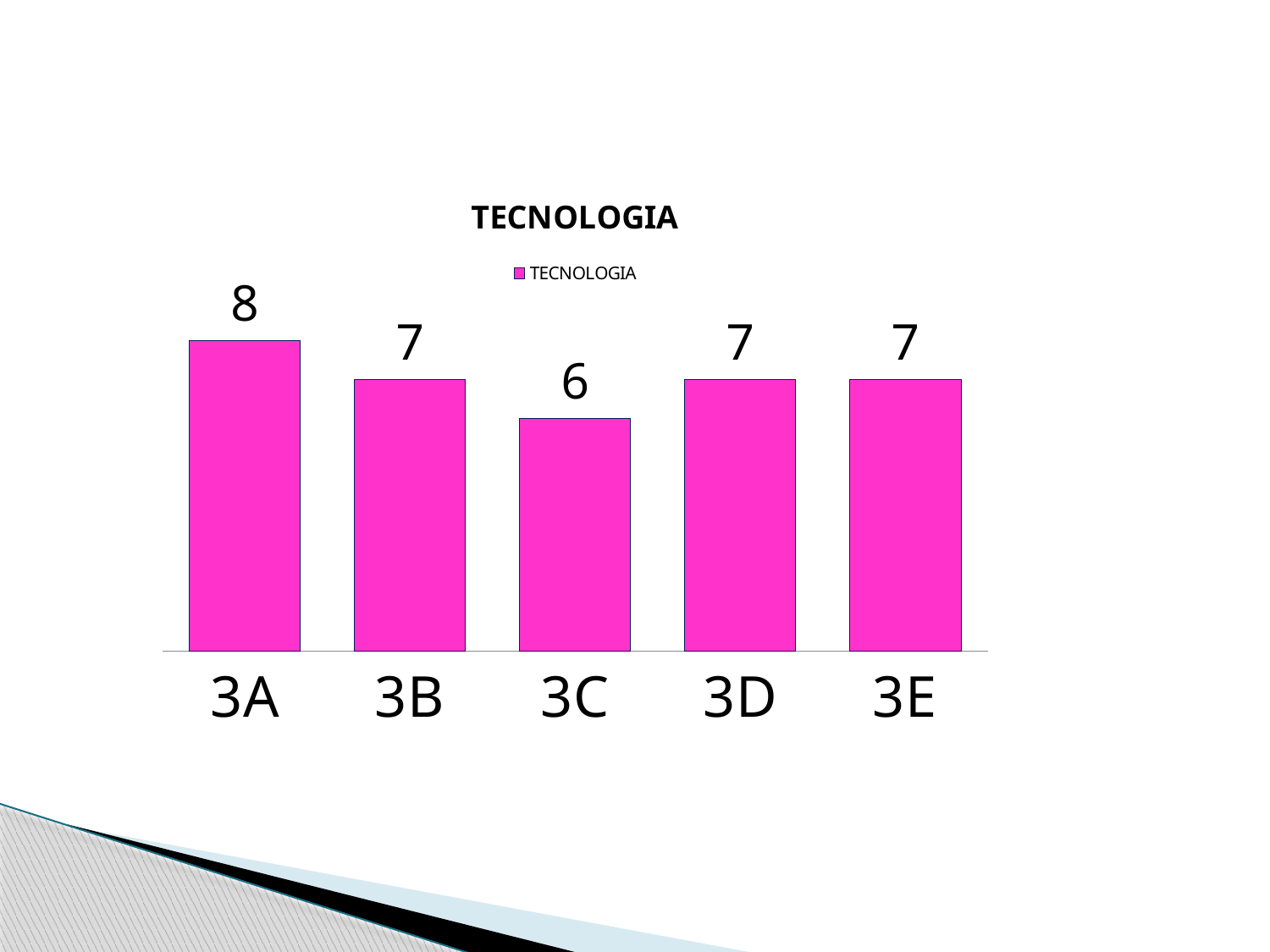
Which category has the lowest value? 3C What is the value for 3D? 7 What is the difference between the values for 3A and 3C? 2 What is the value for 3A? 8 What is the title of the chart? TECNOLOGIA How many series does the legend list? 1 What kind of chart is shown? bar chart Which category has the highest value? 3A What is the value for 3C? 6 How many categories are shown on the x axis? 5 What is the difference between the values for 3B and 3C? 1 Which is larger, the value for 3A or the value for 3E? 3A